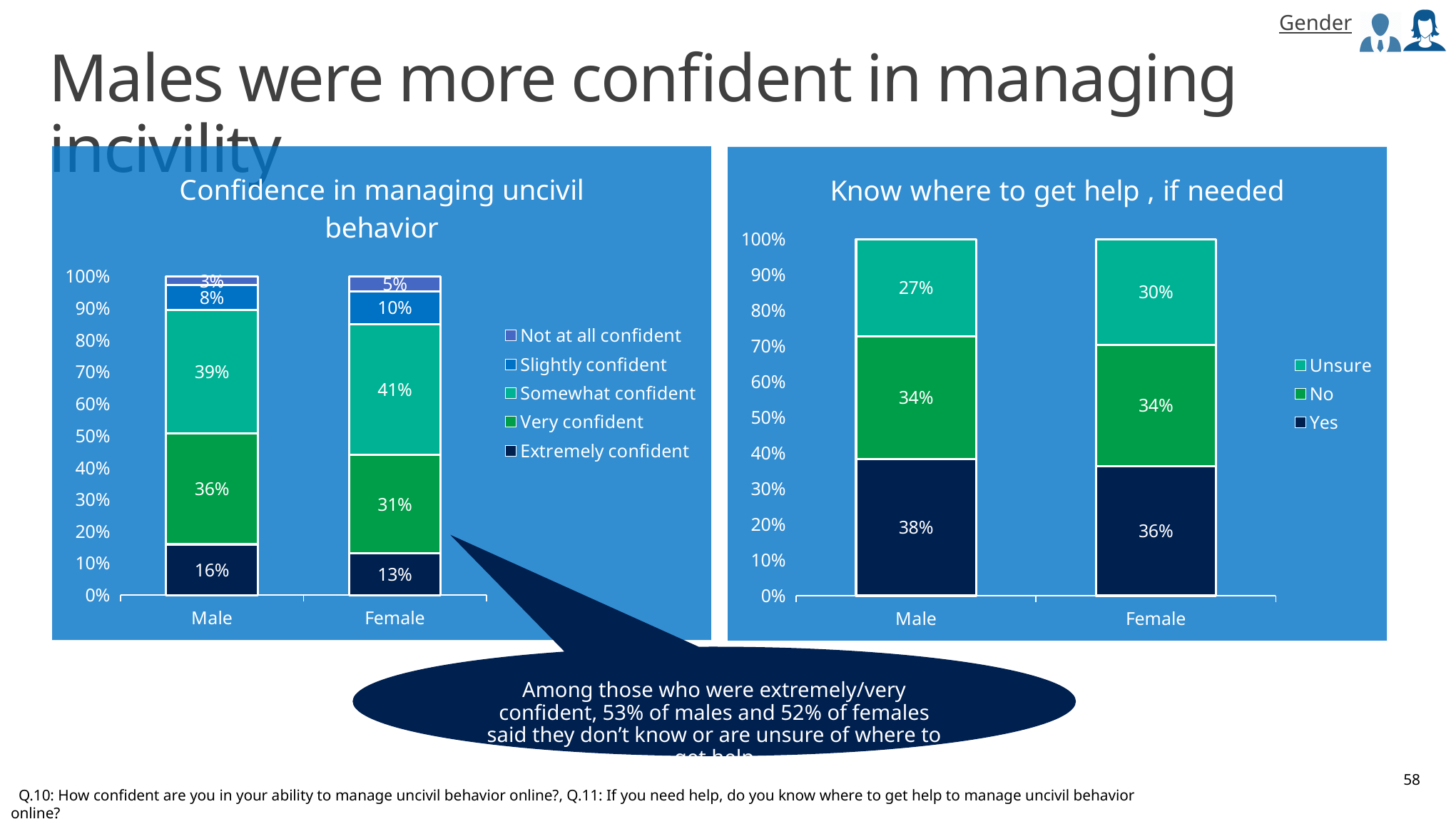
What type of chart is the 'Know where to get help, if needed' chart? Stacked bar chart In the 'Know where to get help, if needed' chart, what is the difference between the Unsure values for females and males? 3% In the 'Know where to get help, if needed' chart, which response category is the largest for males? Yes In the 'Know where to get help, if needed' chart, what percentage of females were Unsure? 30% In the 'Confidence in managing uncivil behavior' chart, what percentage of females were somewhat confident? 41% In the 'Confidence in managing uncivil behavior' chart, what percentage of females were not at all confident? 5% In the 'Know where to get help, if needed' chart, what percentage of males answered Yes? 38% In the 'Confidence in managing uncivil behavior' chart, which gender has the larger 'Slightly confident' value? Female How many categories are shown on the x axis of the 'Know where to get help, if needed' chart? 2 In the 'Confidence in managing uncivil behavior' chart, what is the difference between the 'Very confident' values for males and females? 5% In the 'Confidence in managing uncivil behavior' chart, what percentage of males were extremely confident? 16% In the 'Confidence in managing uncivil behavior' chart, how many series does the legend list? 5